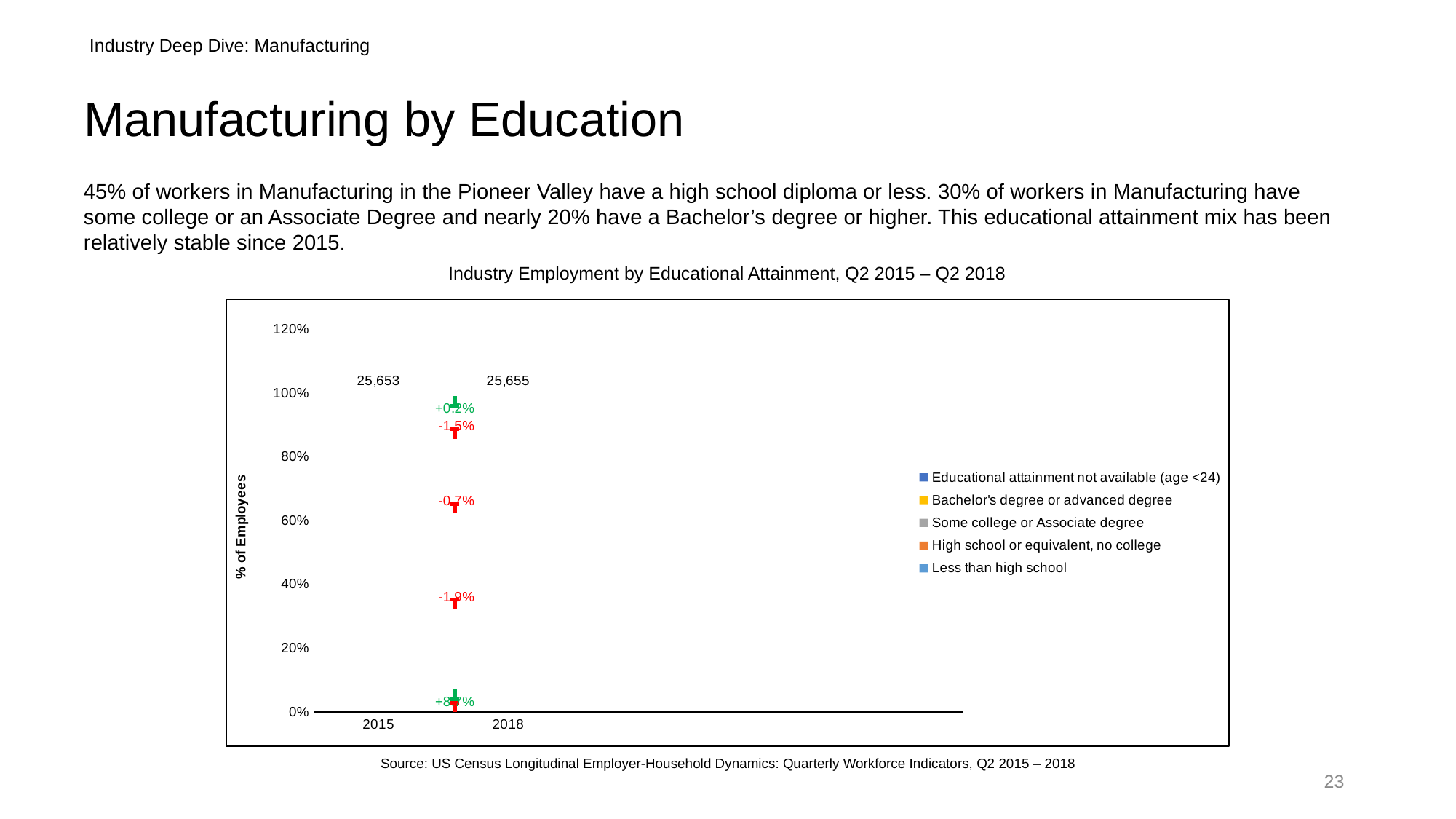
How many series does the chart's legend list? 5 How many years are shown on the x axis of the chart? 2 What is the label on the y axis of the chart? % of Employees What is the most negative change label shown between the 2015 and 2018 columns? -1.9% What is the difference between the labelled totals for 2018 and 2015? 2 What is the title of the chart? Industry Employment by Educational Attainment, Q2 2015 – Q2 2018 What total employment figure is labelled above the 2018 column? 25,655 What is the largest positive change label shown between the 2015 and 2018 columns? +8.7% What total employment figure is labelled above the 2015 column? 25,653 Which year has the larger labelled total employment, 2015 or 2018? 2018 How many change labels between the columns are shown in red (negative)? 3 How many change labels between the columns are shown in green (positive)? 2